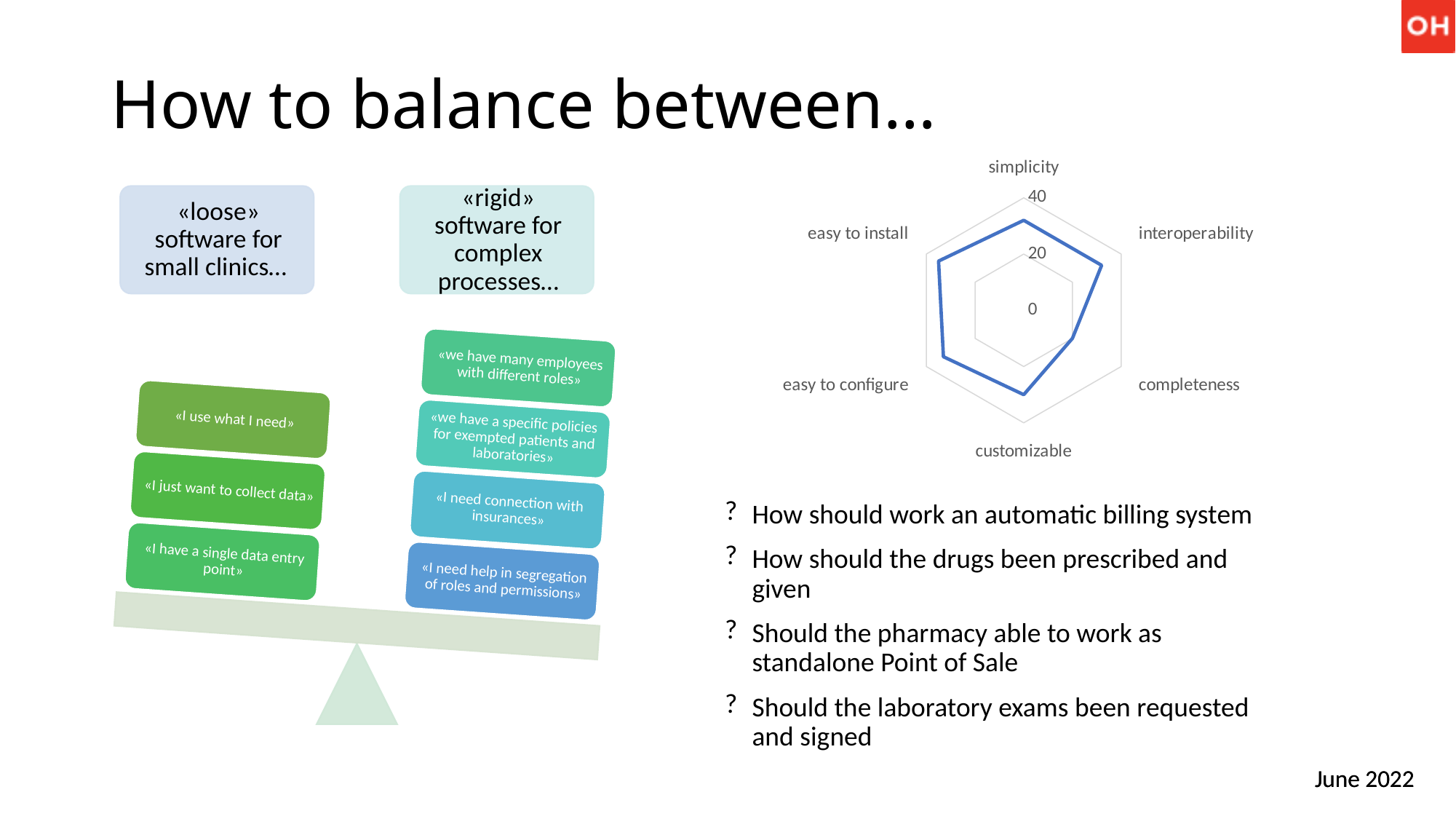
What kind of chart is shown on the right side of the slide? radar chart Which category label appears at the top of the radar chart? simplicity Is the value for customizable greater or less than 20? greater Is the value for easy to configure greater or less than 20? greater Is the value for interoperability greater or less than 40? less Which category has the lowest value on the radar chart? completeness What is the highest tick value shown on the radar chart's scale? 40 How many categories (axes) does the radar chart have? 6 Which is larger on the radar chart, the value for completeness or the value for simplicity? simplicity Which is larger on the radar chart, the value for easy to install or the value for completeness? easy to install